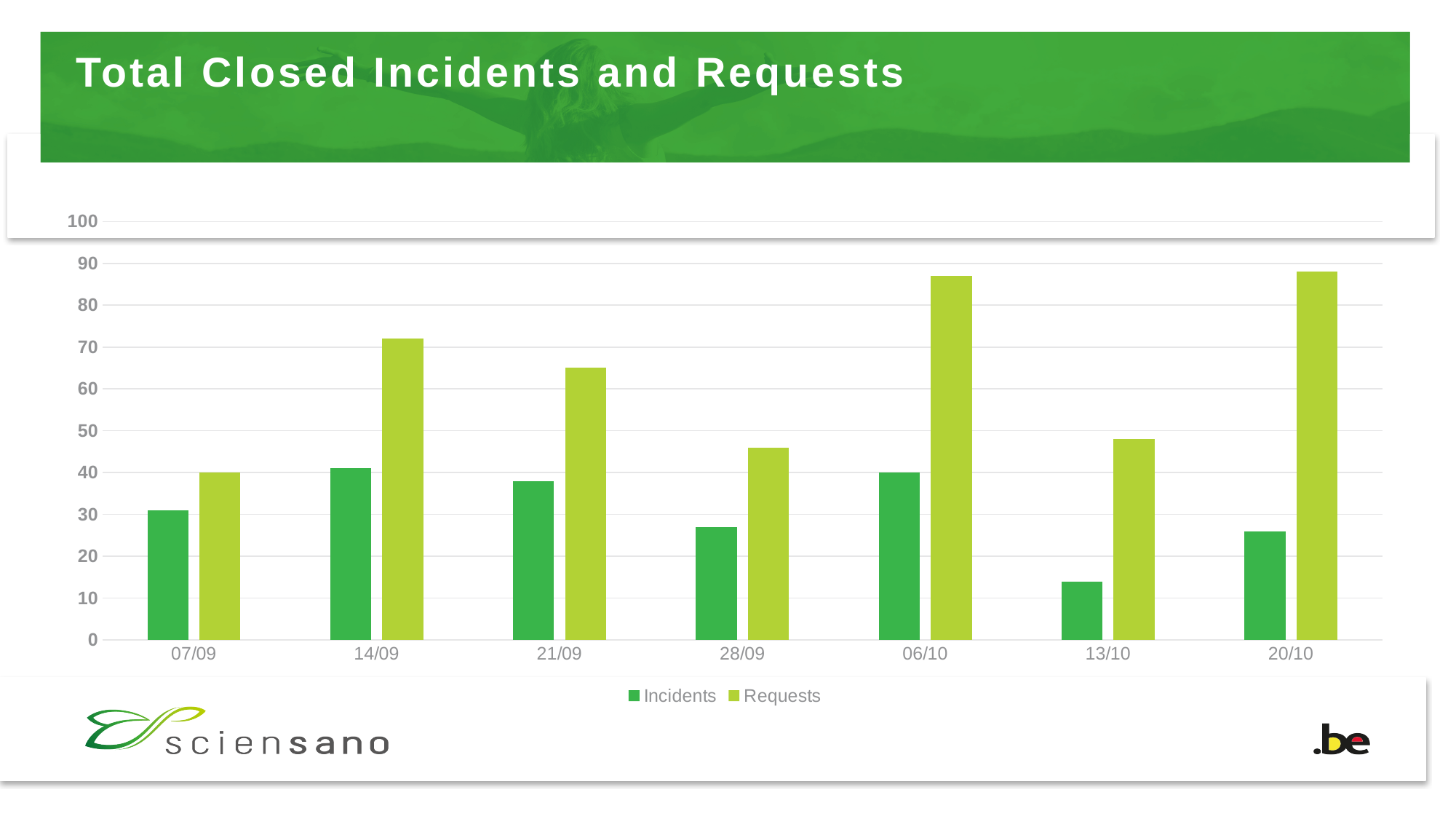
How many dates are shown on the x axis of the chart? 7 How many series does the chart legend list? 2 On 14/09, which is larger: Incidents or Requests? Requests Which series does the lighter green colour represent in the chart? Requests Is the Requests value for 06/10 greater or less than 80? greater What is the title of the chart on the slide? Total Closed Incidents and Requests What kind of chart is shown on the slide? bar chart On which date is the Incidents bar lowest? 13/10 Is the Requests value for 21/09 greater or less than 60? greater Is the Incidents value for 13/10 greater or less than 20? less On which date is the Requests bar lowest? 07/09 Which date has the larger Requests value: 14/09 or 21/09? 14/09